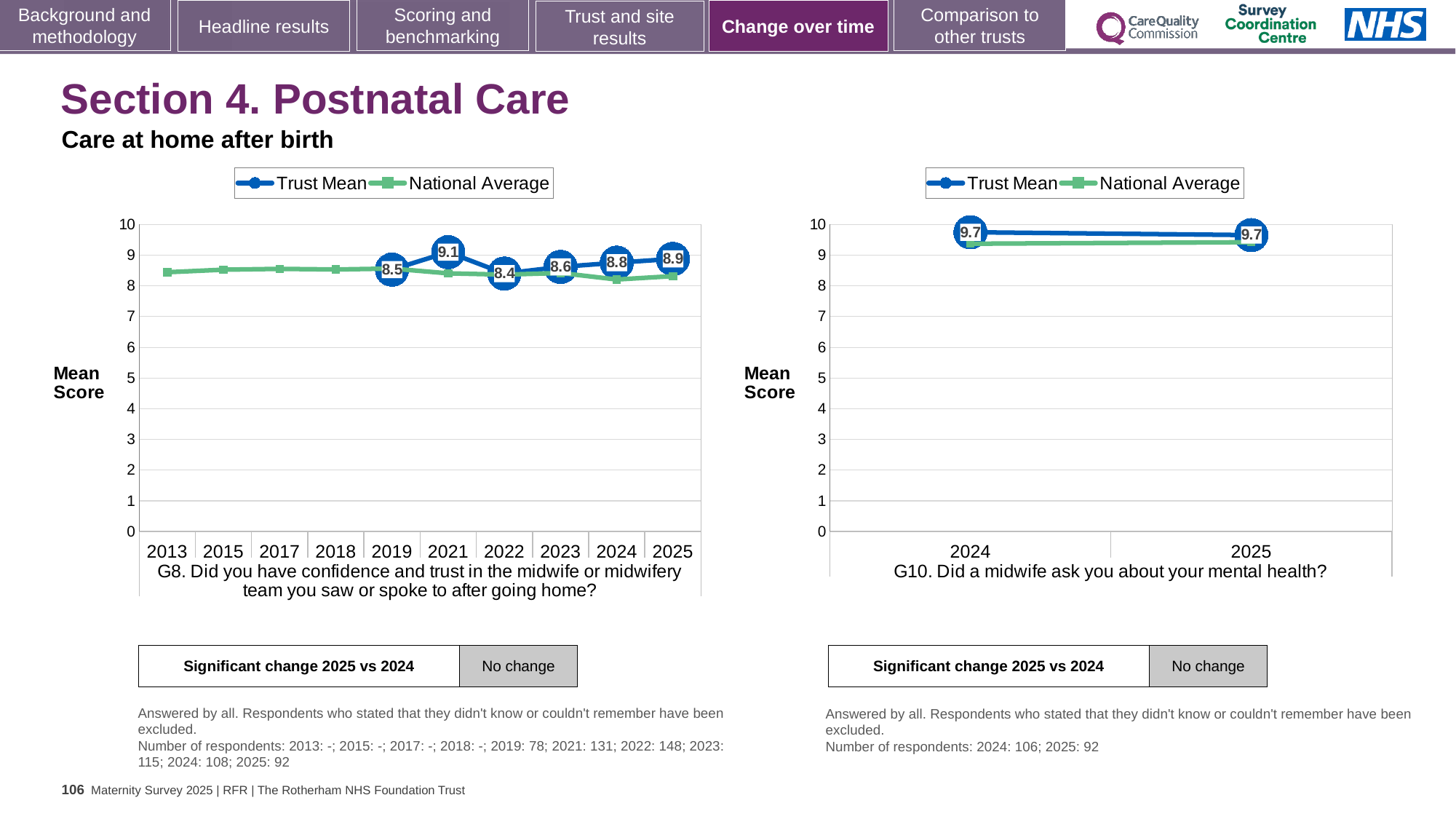
In the G8 chart (left), what is the difference between the Trust Mean in 2021 and in 2022? 0.7 In the G8 chart (left), which year has the highest Trust Mean? 2021 In the G8 chart (left), what is the Trust Mean for 2022? 8.4 In the G8 chart (left), how many years are shown on the x axis? 10 In the G8 chart (left), what is the Trust Mean for 2021? 9.1 In the G8 chart (left), what is the Trust Mean for 2025? 8.9 In the G10 chart (right), how many series does the legend list? 2 In the G10 chart (right), what is the Trust Mean for 2024? 9.7 In the G8 chart (left), which year has the lowest labelled Trust Mean? 2022 What type of chart is the G10 chart (right)? Line chart In the G8 chart (left), is the Trust Mean higher in 2024 or in 2023? 2024 In the G8 chart (left), is the National Average for 2013 greater or less than 8? greater